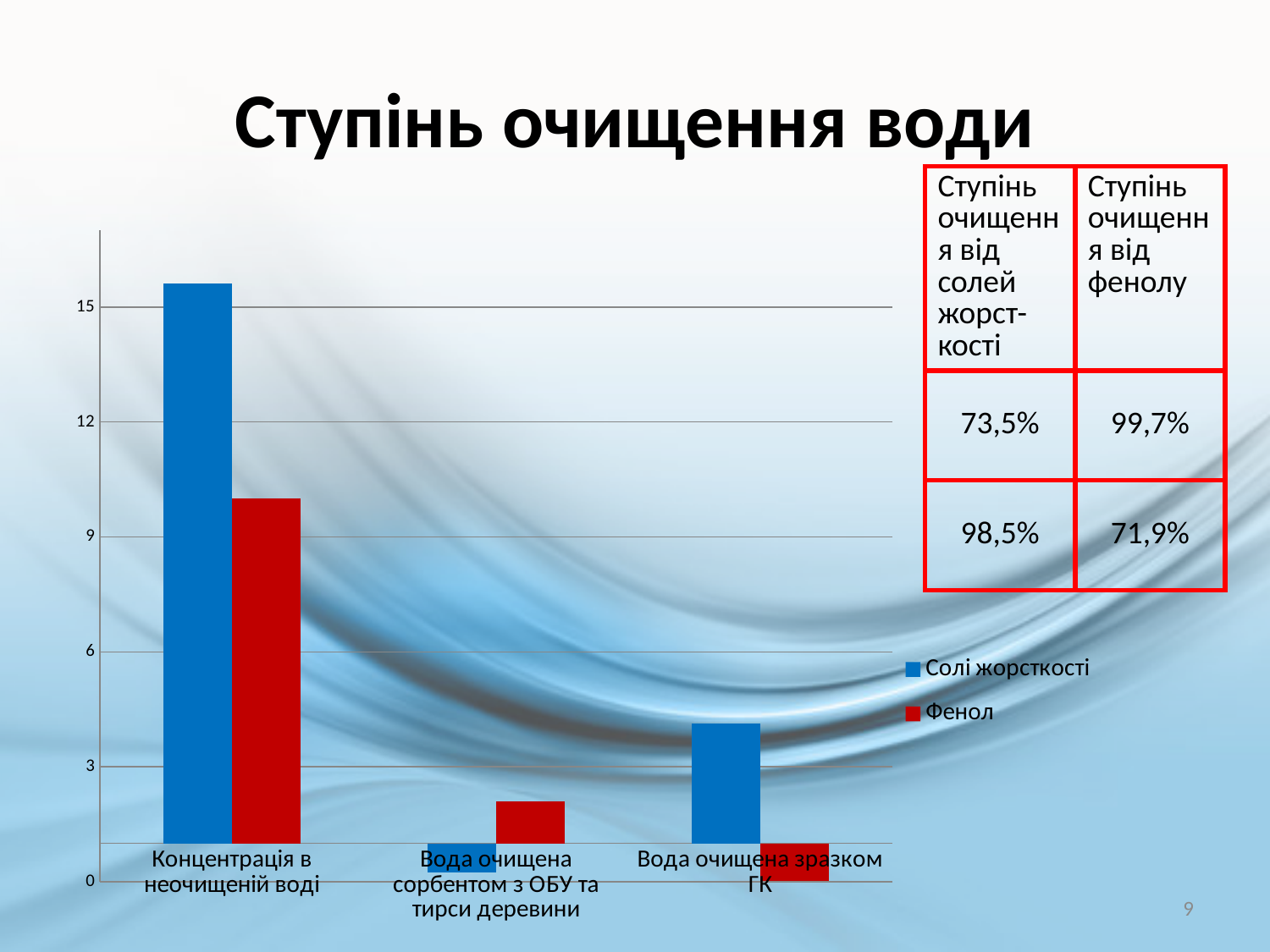
How many categories are shown on the x axis of the chart? 3 Is the value for Фенол in Вода очищена сорбентом з ОБУ та тирси деревини greater or less than 3? less Which category has the highest value for Фенол? Концентрація в неочищеній воді Which category has the highest value for Солі жорсткості? Концентрація в неочищеній воді Which series is shown in blue in the chart? Солі жорсткості Which series is shown in red in the chart? Фенол Which category has the lowest value for Фенол? Вода очищена зразком ГК Is the value for Солі жорсткості in Концентрація в неочищеній воді greater or less than 15? greater For Вода очищена зразком ГК, which is larger: Солі жорсткості or Фенол? Солі жорсткості What kind of chart is shown on the slide? bar chart Which category has the lowest value for Солі жорсткості? Вода очищена сорбентом з ОБУ та тирси деревини How many series does the chart legend list? 2